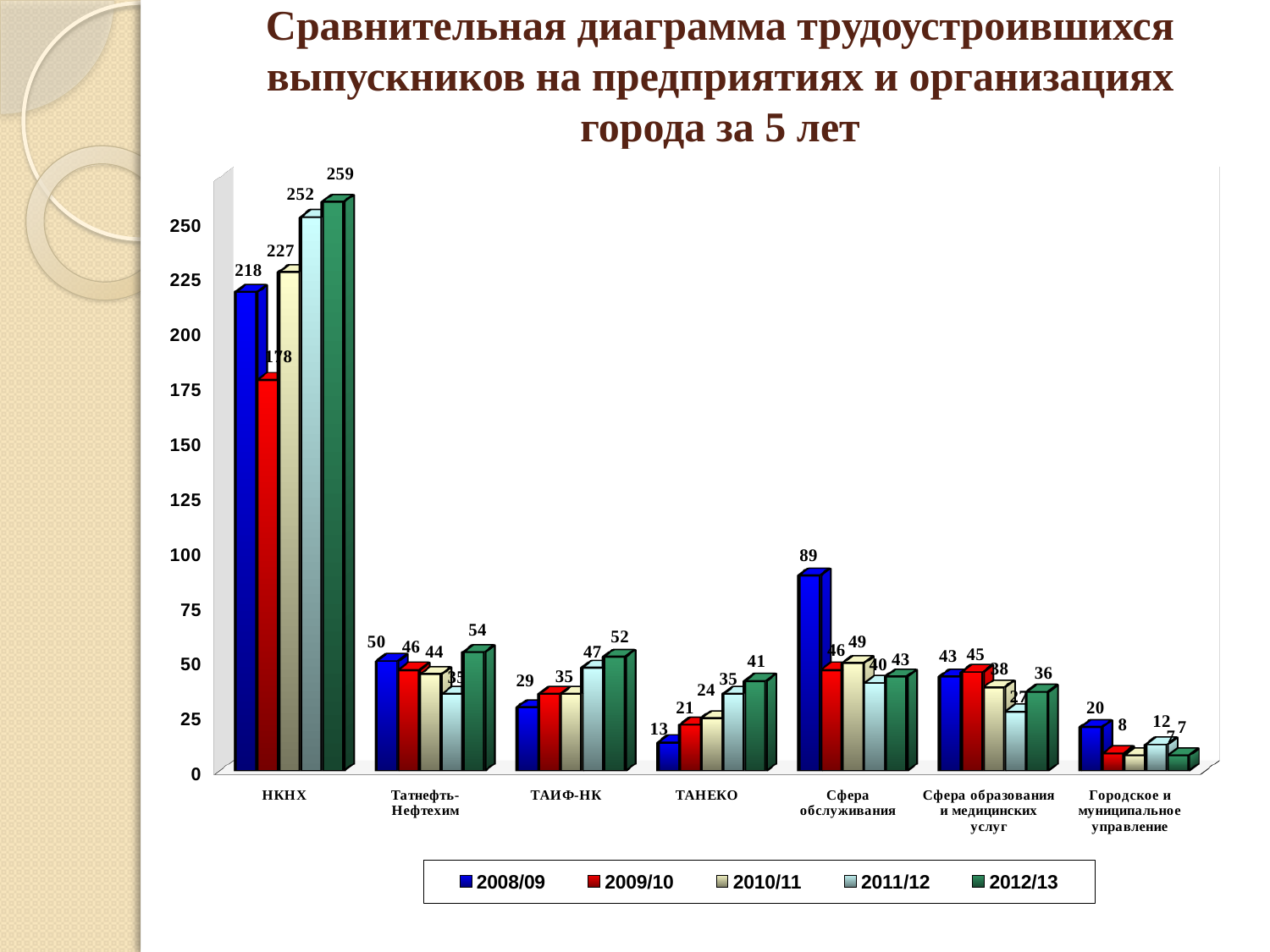
Is the 2009/10 value for НКНХ greater or less than 200? less In the 2008/09 series, which is larger: Сфера обслуживания or Сфера образования и медицинских услуг? Сфера обслуживания Which category has the lowest value in the 2008/09 series? ТАНЕКО How many series does the legend list? 5 What is the value for ТАНЕКО in the 2011/12 series? 35 What is the value for Сфера обслуживания in the 2008/09 series? 89 Do the values for ТАНЕКО rise or fall from 2008/09 to 2012/13? rise What kind of chart is shown on the slide? bar chart Which category has the highest value in the 2012/13 series? НКНХ What is the difference between the 2012/13 and 2008/09 values for НКНХ? 41 How many categories are shown on the x axis? 7 What is the value for НКНХ in the 2012/13 series? 259